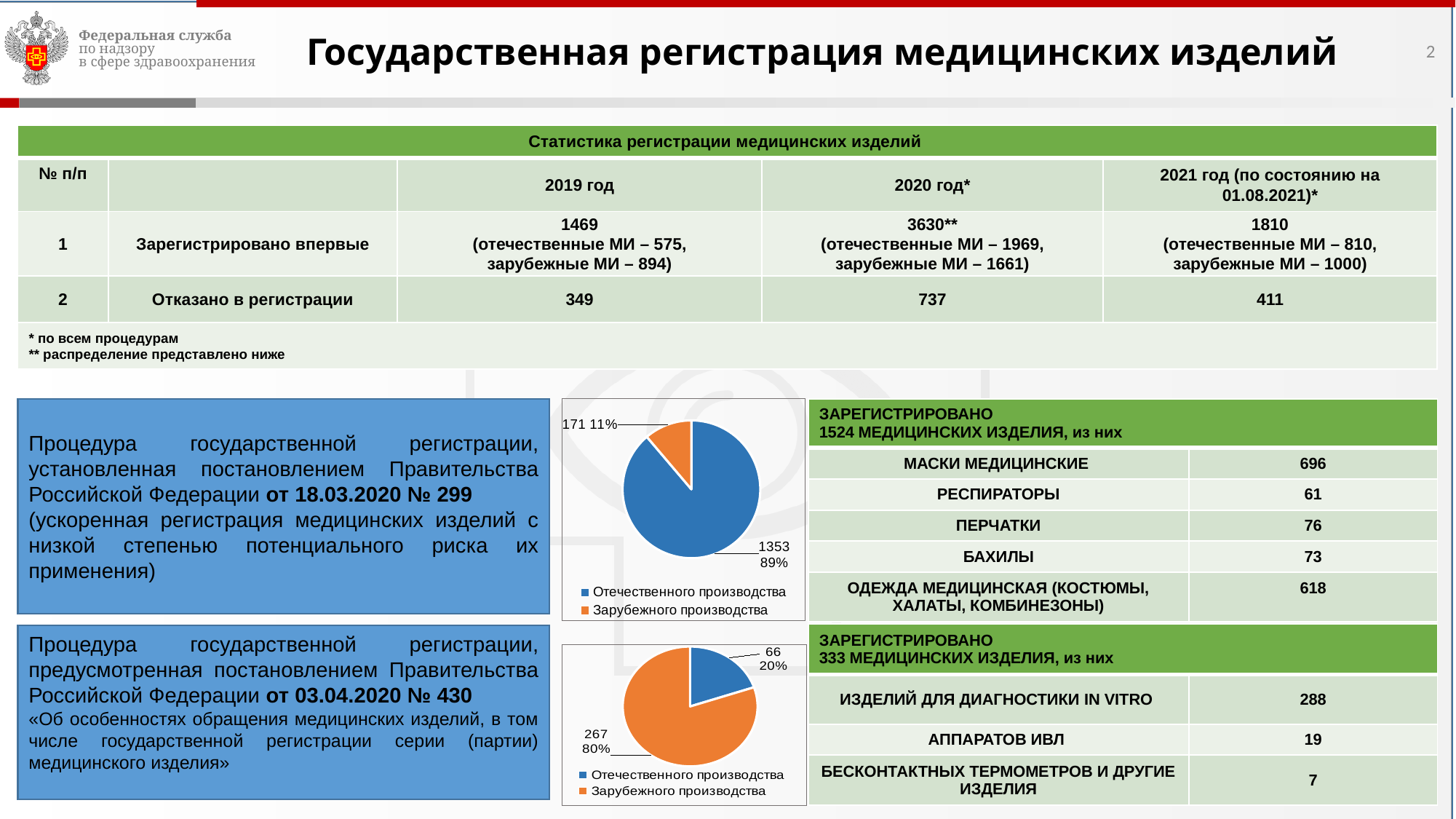
In the upper pie chart, what is the difference between Отечественного производства and Зарубежного производства? 1182 In the upper pie chart, what share of the pie is Отечественного производства? 89% In the upper pie chart, what share of the pie is Зарубежного производства? 11% In the lower pie chart, what share of the pie is Зарубежного производства? 80% In the upper pie chart, what is the value for Зарубежного производства? 171 What kind of chart is the upper chart in the middle of the slide? pie chart In the upper pie chart, which slice is the largest? Отечественного производства How many entries does the legend of the lower pie chart list? 2 In the lower pie chart, which slice is the smallest? Отечественного производства In the lower pie chart, what is the value for Отечественного производства? 66 In the upper pie chart, what is the value for Отечественного производства? 1353 In the lower pie chart, what is the value for Зарубежного производства? 267